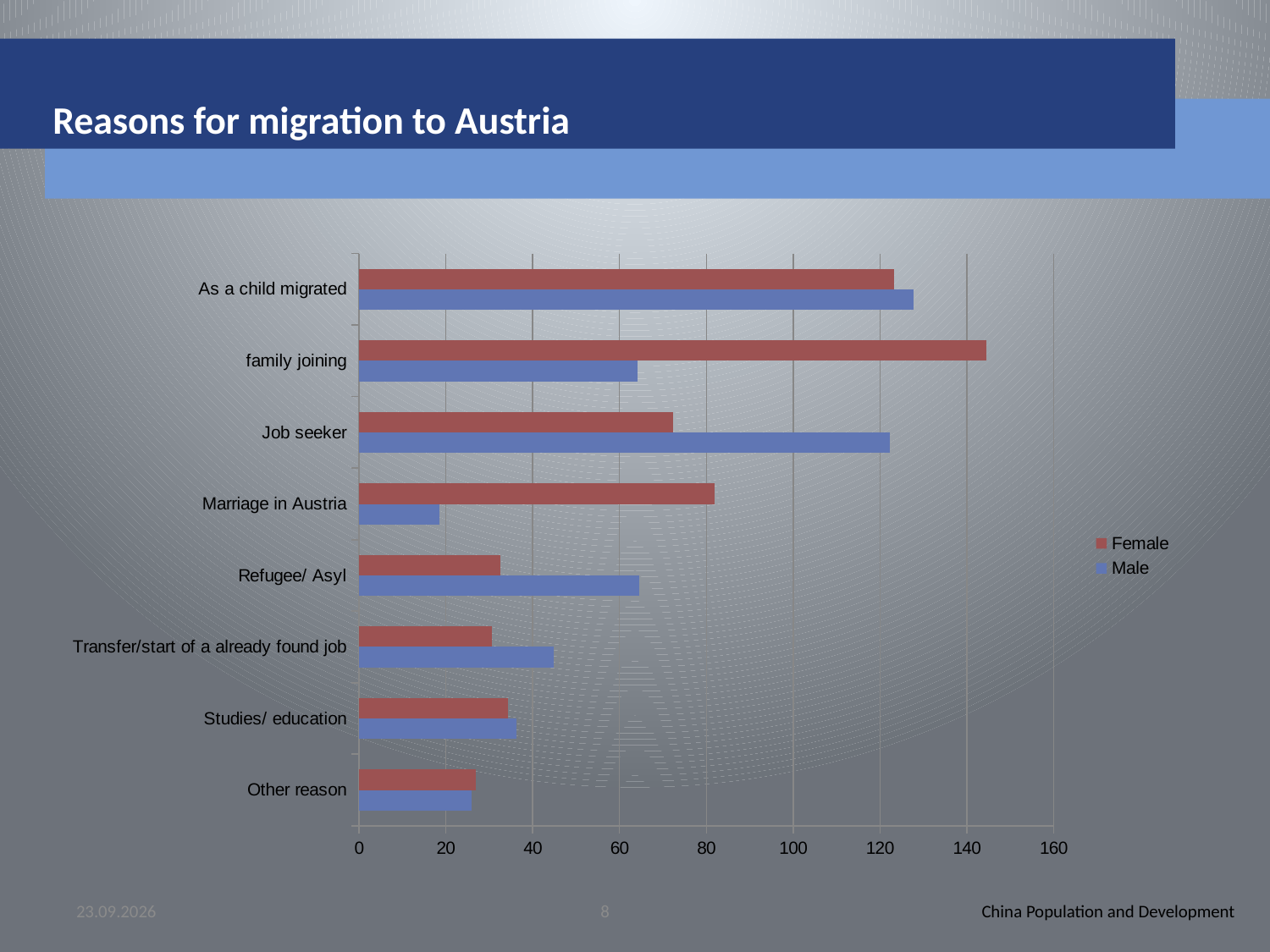
Is the Male value for Refugee/ Asyl greater or less than 60? greater Which colour represents the Female series in the legend? red How many series does the legend list? 2 For Job seeker, is the Male or the Female value larger? Male Which reason has the highest Female value? family joining How many reasons for migration are listed on the chart? 8 Is the Female value for family joining greater or less than 140? greater Is the Male value for Marriage in Austria greater or less than 20? less What kind of chart is shown on the slide? bar chart For Marriage in Austria, is the Female or the Male value larger? Female Which reason has the highest Male value? As a child migrated Which reason has the lowest Male value? Marriage in Austria